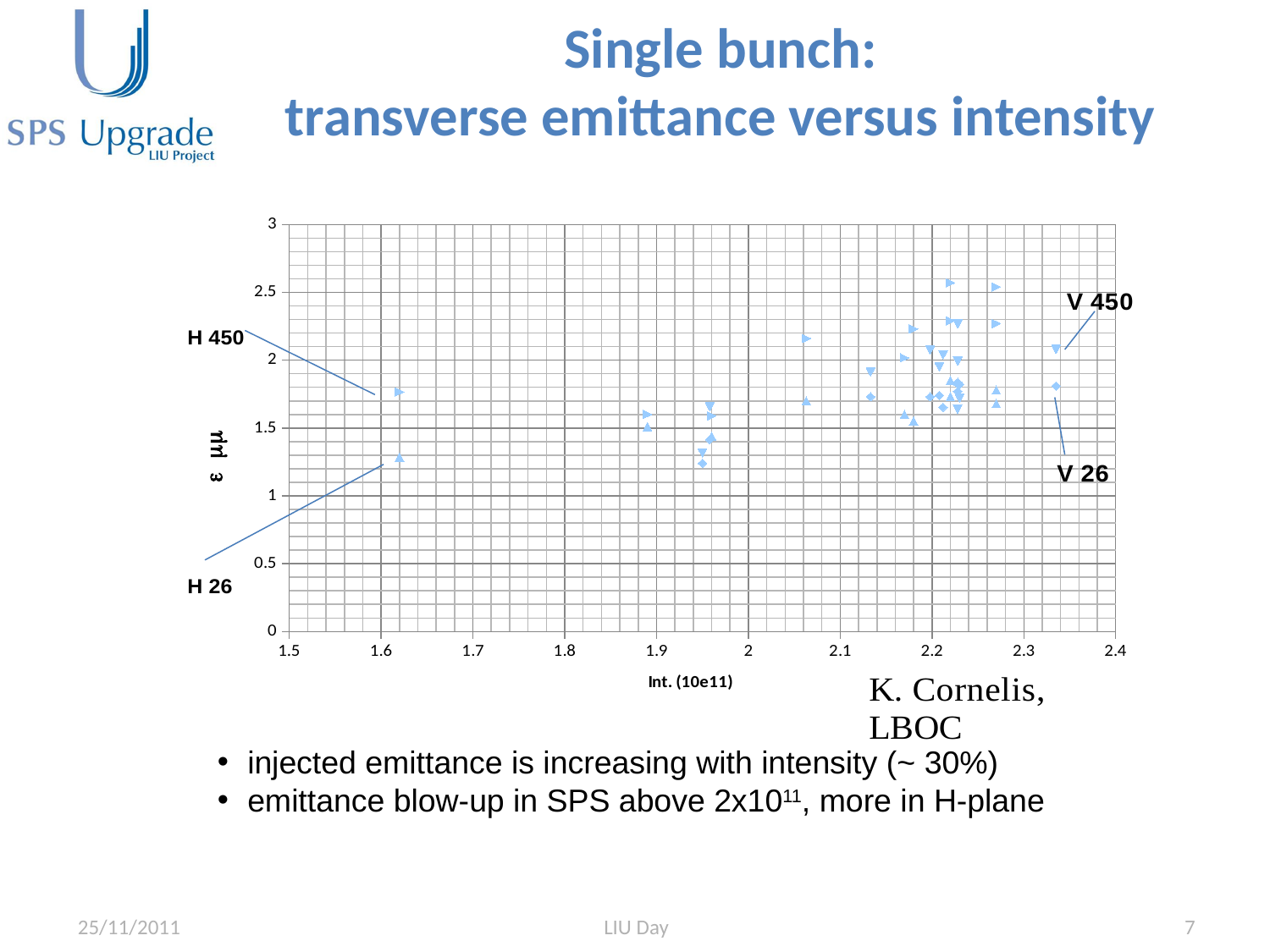
Is the value of the H 26 point at intensity about 1.6 greater or less than 1.5? less Do the emittance values generally rise or fall as intensity increases along the x axis? rise Is the lowest plotted point on the chart greater or less than 1.5? less What is the label of the x axis of the chart? Int. (10e11) Is the value of the V 26 point at intensity about 2.33 greater or less than 2? less What is the maximum value shown on the y axis of the chart? 3 Which of the two points at intensity about 1.6 is larger, H 450 or H 26? H 450 How many data series are annotated on the chart (H 450, H 26, V 450, V 26)? 4 What kind of chart is shown on the slide? scatter chart